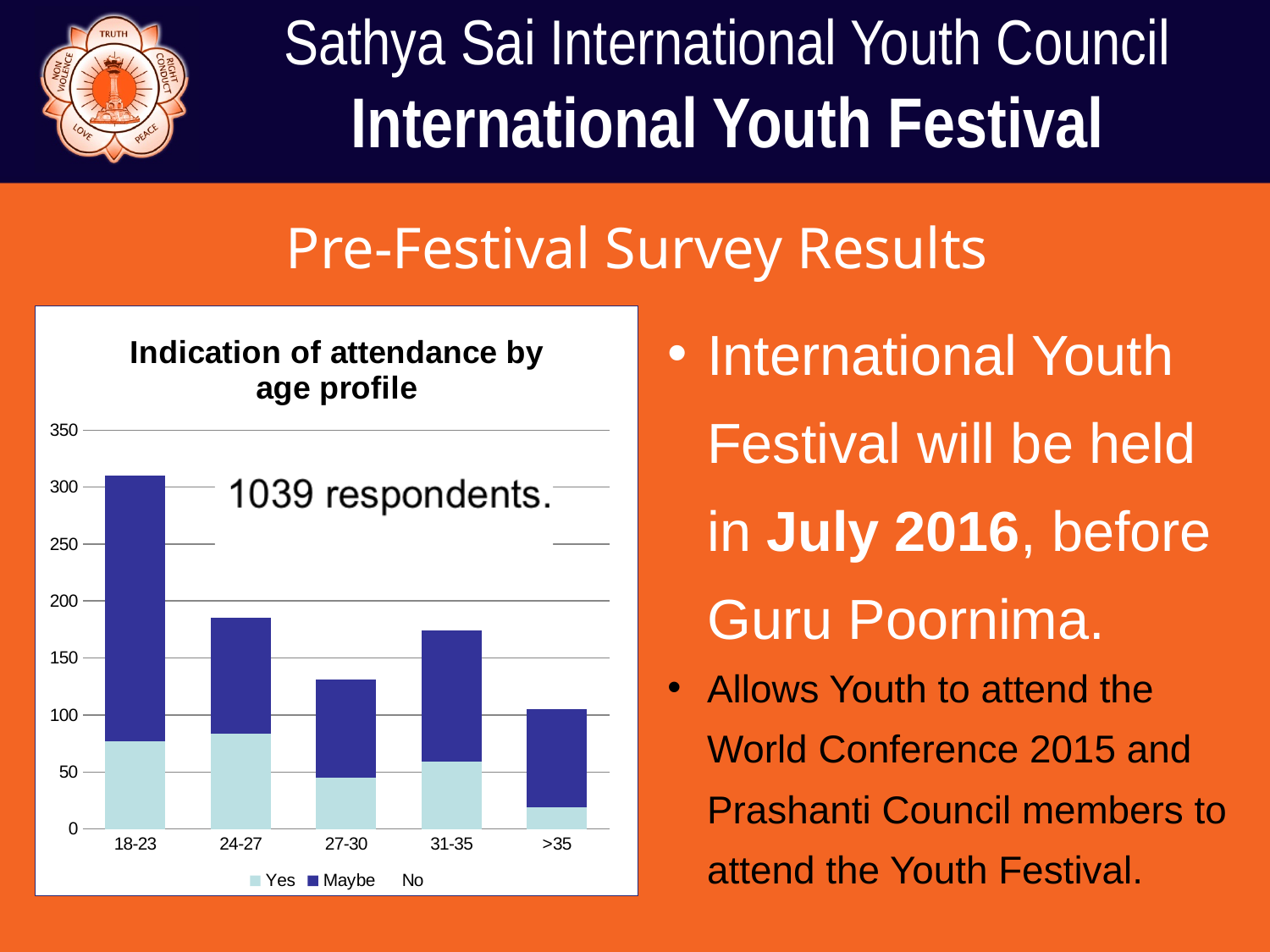
Is the total bar height for the 27-30 age group greater or less than 100? greater What is the title of the chart? Indication of attendance by age profile Is the total bar height for the >35 age group greater or less than 150? less How many series does the chart's legend list? 3 Which age group has the tallest stacked bar in the chart? 18-23 Which age group has the shortest stacked bar in the chart? >35 How many respondents does the annotation on the chart say took part in the survey? 1039 respondents How many age groups are shown on the x axis of the chart? 5 Is the total bar height for the 24-27 age group greater or less than 200? less What kind of chart is shown on the slide? Stacked bar chart Which age group has a taller stacked bar, 31-35 or 27-30? 31-35